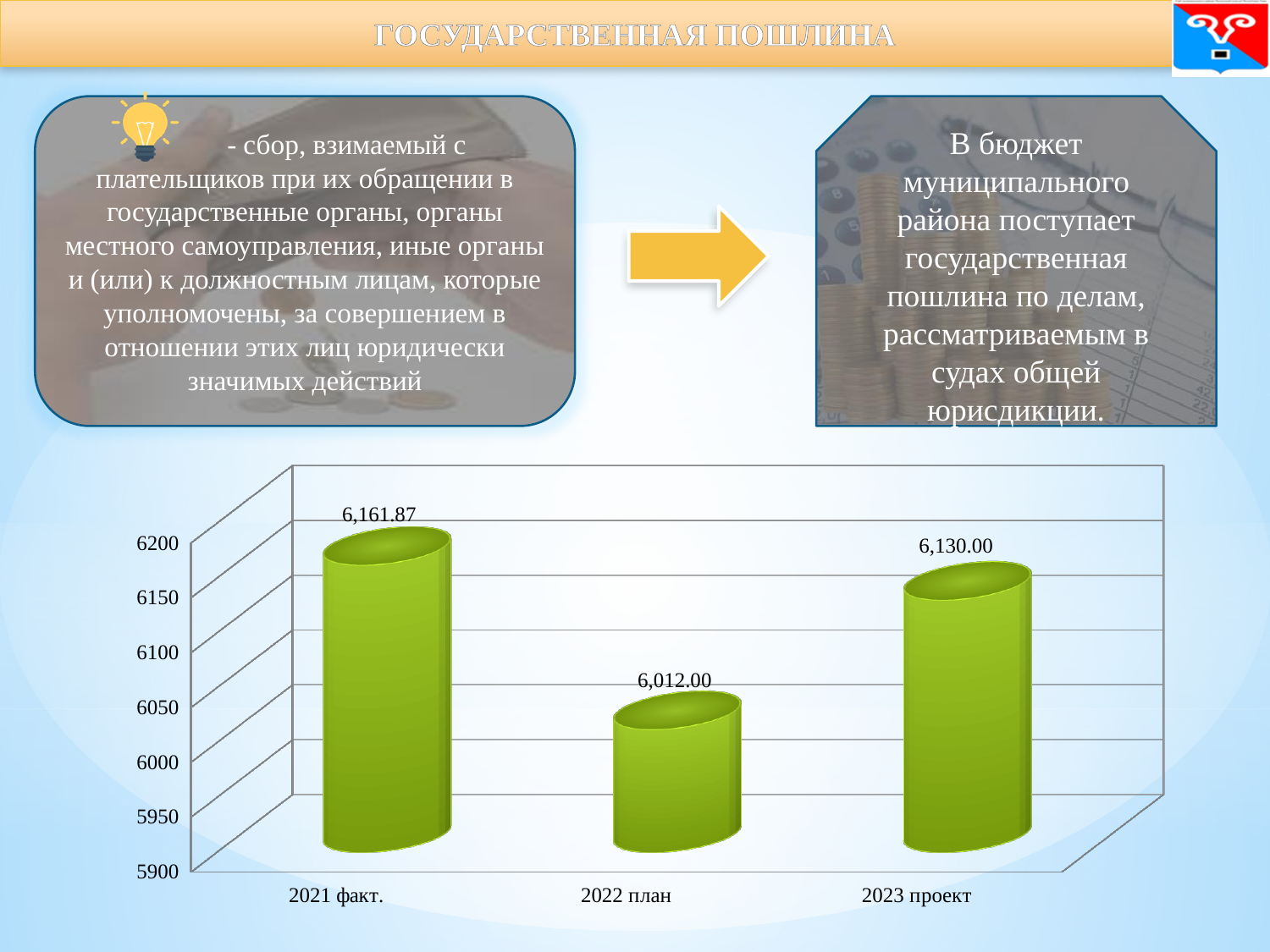
Which category has the lowest value? 2022 план What is the value for 2022 план? 6,012.00 Which category has the highest value? 2021 факт. What kind of chart is shown on the slide? bar chart Is the value for 2022 план greater or less than 6050? less Do the values rise or fall from 2022 план to 2023 проект? rise Which is larger, the value for 2023 проект or the value for 2021 факт.? 2021 факт. How many categories are shown on the x axis? 3 What is the value for 2023 проект? 6,130.00 What is the difference between the values for 2023 проект and 2022 план? 118.00 What is the difference between the values for 2021 факт. and 2022 план? 149.87 What is the value for 2021 факт.? 6,161.87